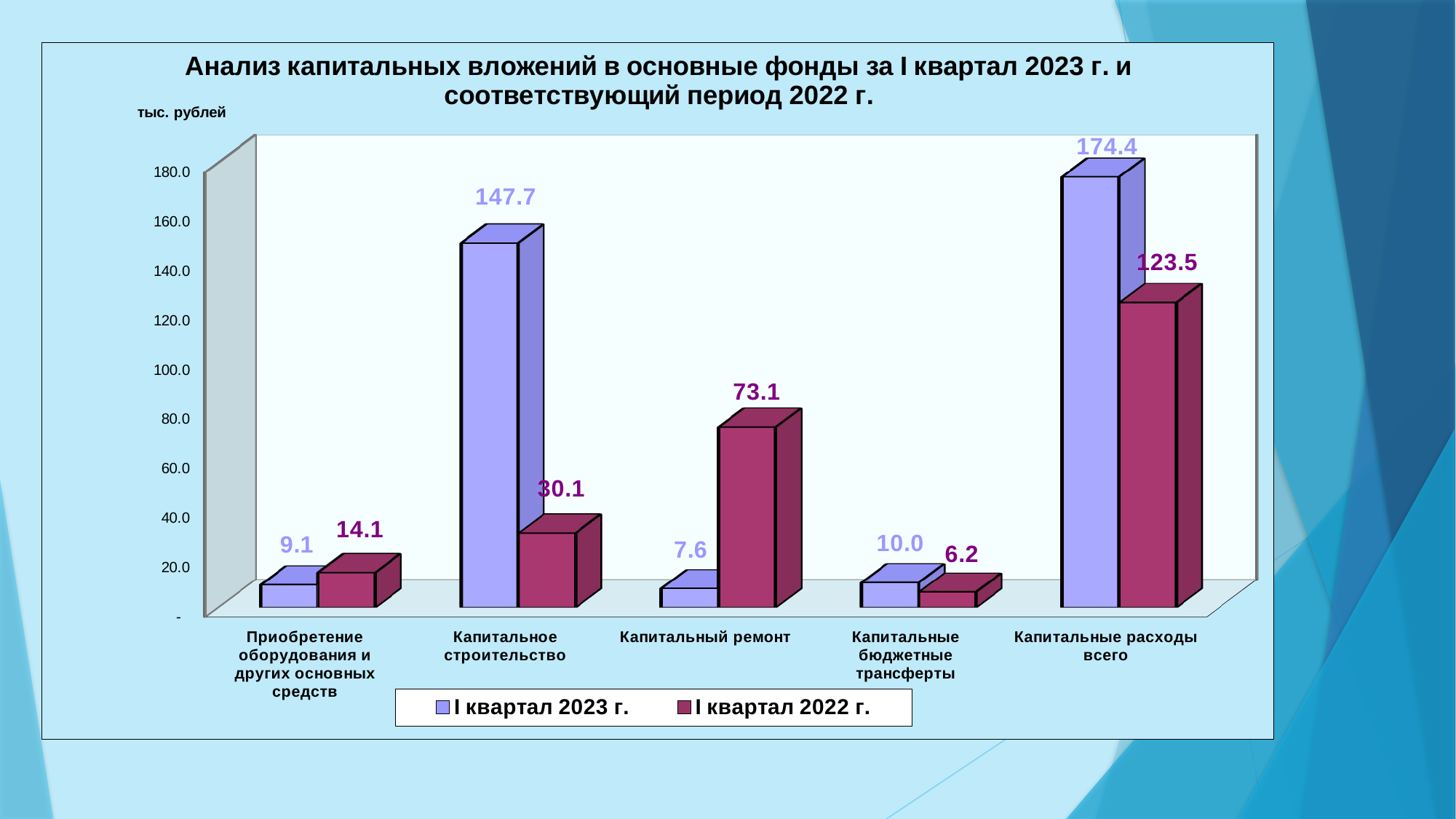
Which category has the lowest value in the I квартал 2023 г. series? Капитальный ремонт Is the I квартал 2023 г. value for Капитальное строительство greater or less than 140.0? greater What is the difference between the I квартал 2023 г. and I квартал 2022 г. values for Капитальные расходы всего? 50.9 Which category has the highest value in the I квартал 2022 г. series? Капитальные расходы всего What is the value for Капитальный ремонт in the I квартал 2022 г. series? 73.1 What is the value for Капитальные бюджетные трансферты in the I квартал 2023 г. series? 10.0 What kind of chart is shown on the slide? Bar chart Which is larger for Приобретение оборудования и других основных средств: the I квартал 2023 г. value or the I квартал 2022 г. value? I квартал 2022 г. How many series does the legend list? 2 What unit is indicated above the vertical axis? тыс. рублей What is the value for Капитальное строительство in the I квартал 2023 г. series? 147.7 How many categories are shown on the x axis? 5